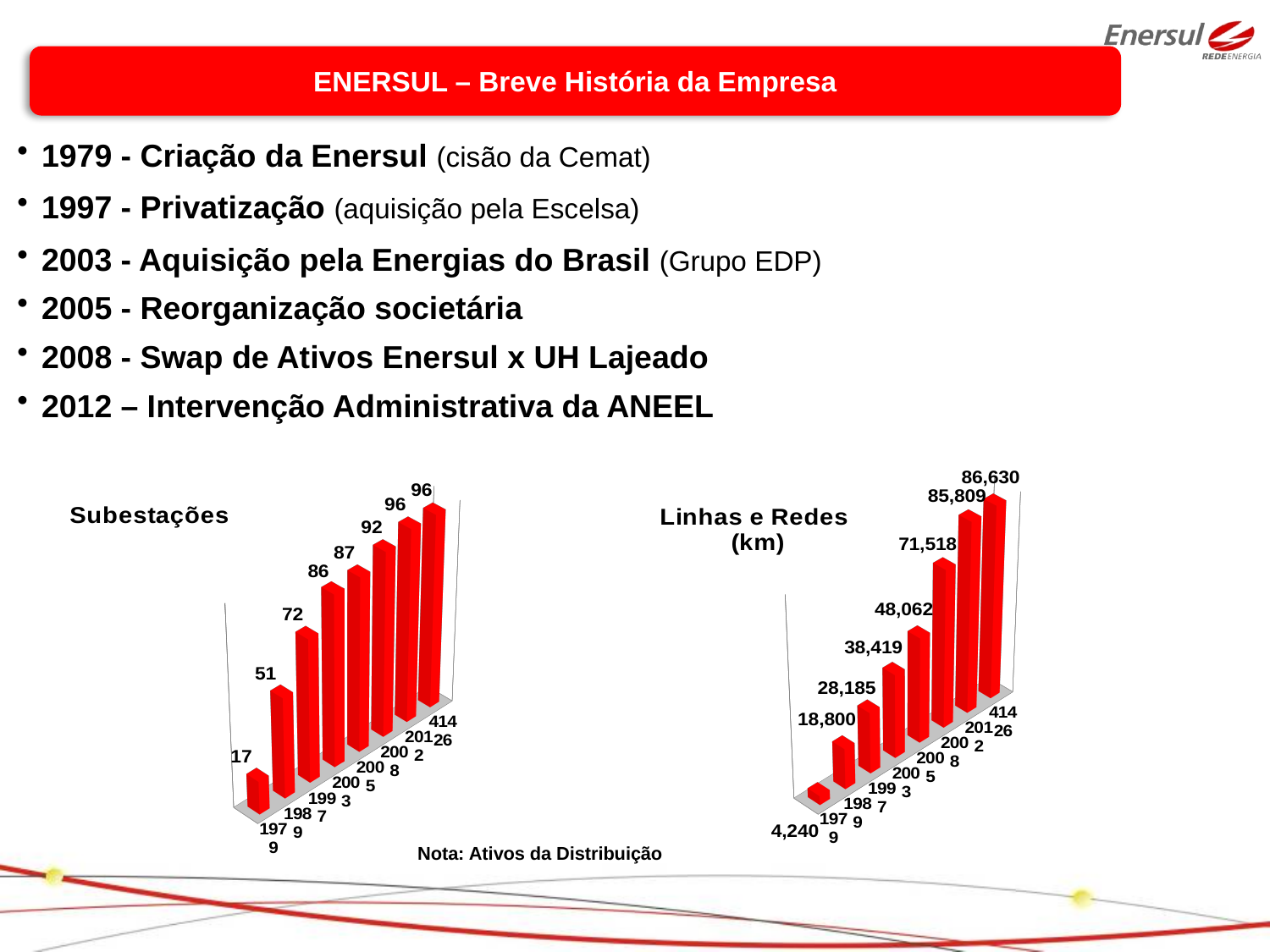
In the "Subestações" chart, what is the highest value shown? 96 In the "Subestações" chart, what is the value of the third bar from the left? 72 In the "Linhas e Redes (km)" chart, what is the highest value shown? 86,630 In the "Linhas e Redes (km)" chart, what is the difference between the last bar (86,630) and the second-to-last bar (85,809)? 821 How many bars are plotted in the "Subestações" chart? 8 In the "Subestações" chart, what is the difference between the highest value (96) and the lowest value (17)? 79 What is the title of the chart on the right side of the slide? Linhas e Redes (km) In the "Subestações" chart, what is the lowest value shown? 17 What kind of chart is the "Subestações" chart? bar chart In the "Linhas e Redes (km)" chart, which is larger: 48,062 or 71,518? 71,518 In the "Linhas e Redes (km)" chart, what is the lowest value shown? 4,240 In the "Linhas e Redes (km)" chart, do the values rise or fall from left to right? rise